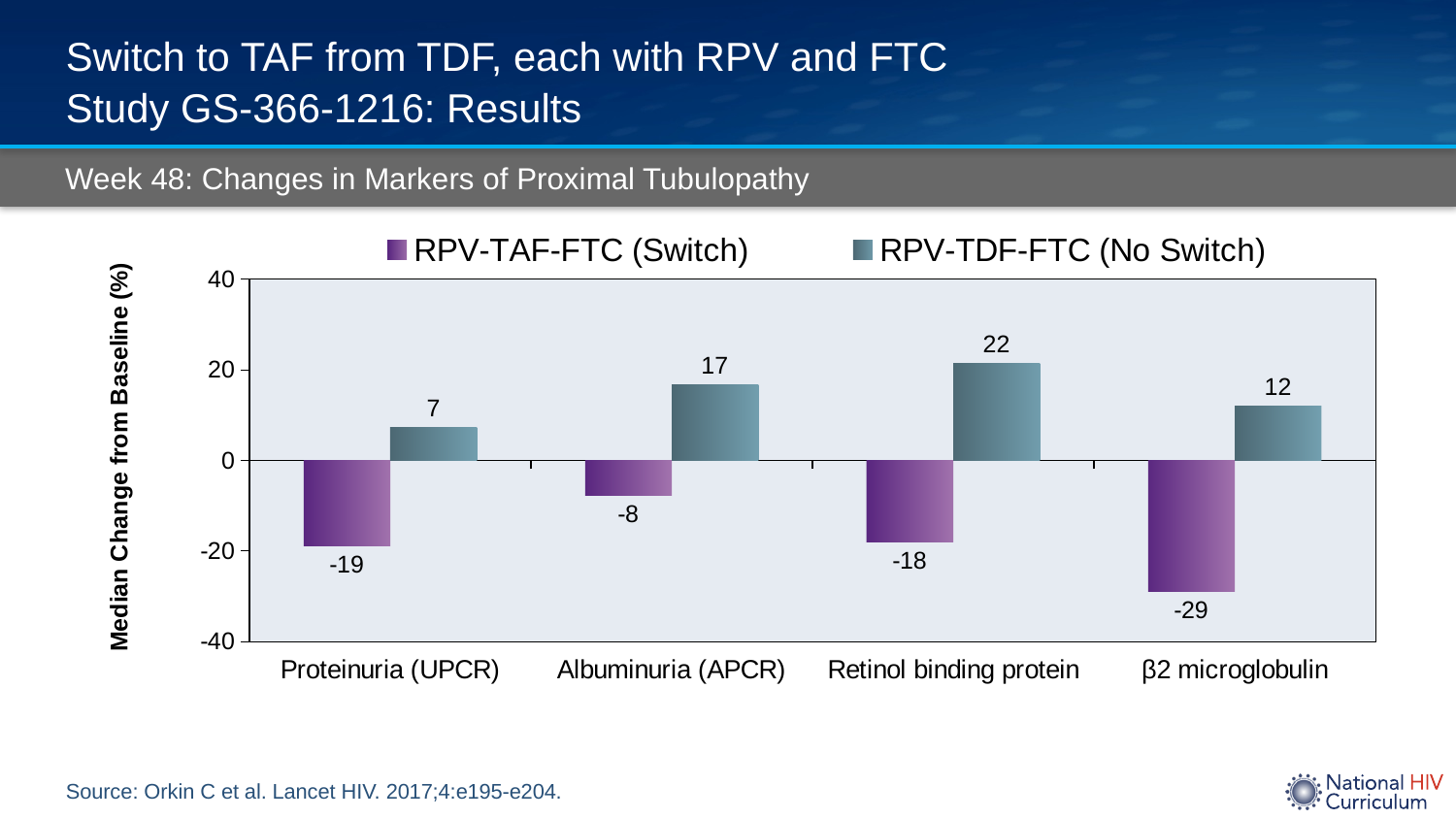
What is the difference between the RPV-TDF-FTC (No Switch) and RPV-TAF-FTC (Switch) values for Proteinuria (UPCR)? 26 Which is larger for β2 microglobulin: the RPV-TAF-FTC (Switch) value or the RPV-TDF-FTC (No Switch) value? RPV-TDF-FTC (No Switch) Which marker has the lowest value in the RPV-TAF-FTC (Switch) group? β2 microglobulin What kind of chart is shown on the slide? Bar chart What is the label of the y axis? Median Change from Baseline (%) What is the median change from baseline for Retinol binding protein in the RPV-TDF-FTC (No Switch) group? 22 Which marker has the highest value in the RPV-TDF-FTC (No Switch) group? Retinol binding protein What is the median change from baseline for β2 microglobulin in the RPV-TAF-FTC (Switch) group? -29 How many markers are shown on the x axis? 4 What is the median change from baseline for Albuminuria (APCR) in the RPV-TDF-FTC (No Switch) group? 17 What is the median change from baseline for Proteinuria (UPCR) in the RPV-TAF-FTC (Switch) group? -19 How many series does the legend list? 2